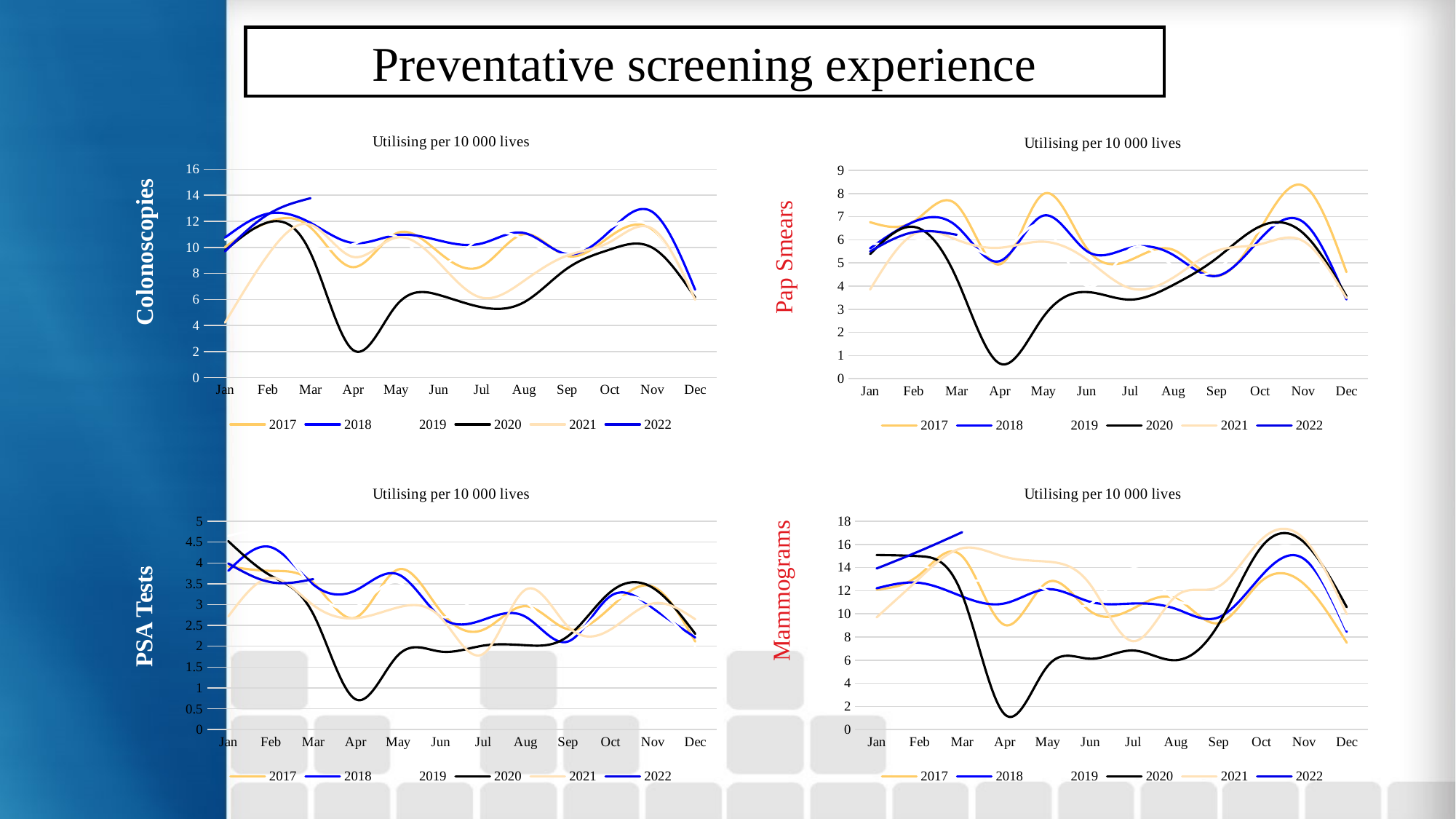
In the Colonoscopies chart, is the 2020 value for Apr greater or less than 4? less What is the highest tick on the y axis of the Mammograms chart? 18 In the Pap Smears chart, is the 2020 value for Apr greater or less than 2? less In the Mammograms chart, does the 2020 series rise or fall from Jan to Apr? fall How many series does the legend of the Pap Smears chart list? 6 In the Colonoscopies chart, which is larger for the 2020 series: the value in Feb or the value in Apr? Feb What is the title shown above each of the four charts? Utilising per 10 000 lives How many months are shown on the x axis of the Mammograms chart? 12 What kind of chart is the Colonoscopies chart? line chart In the Mammograms chart, is the 2020 value for Apr greater or less than 4? less In the Colonoscopies chart, in which month does the 2020 series reach its lowest value? Apr